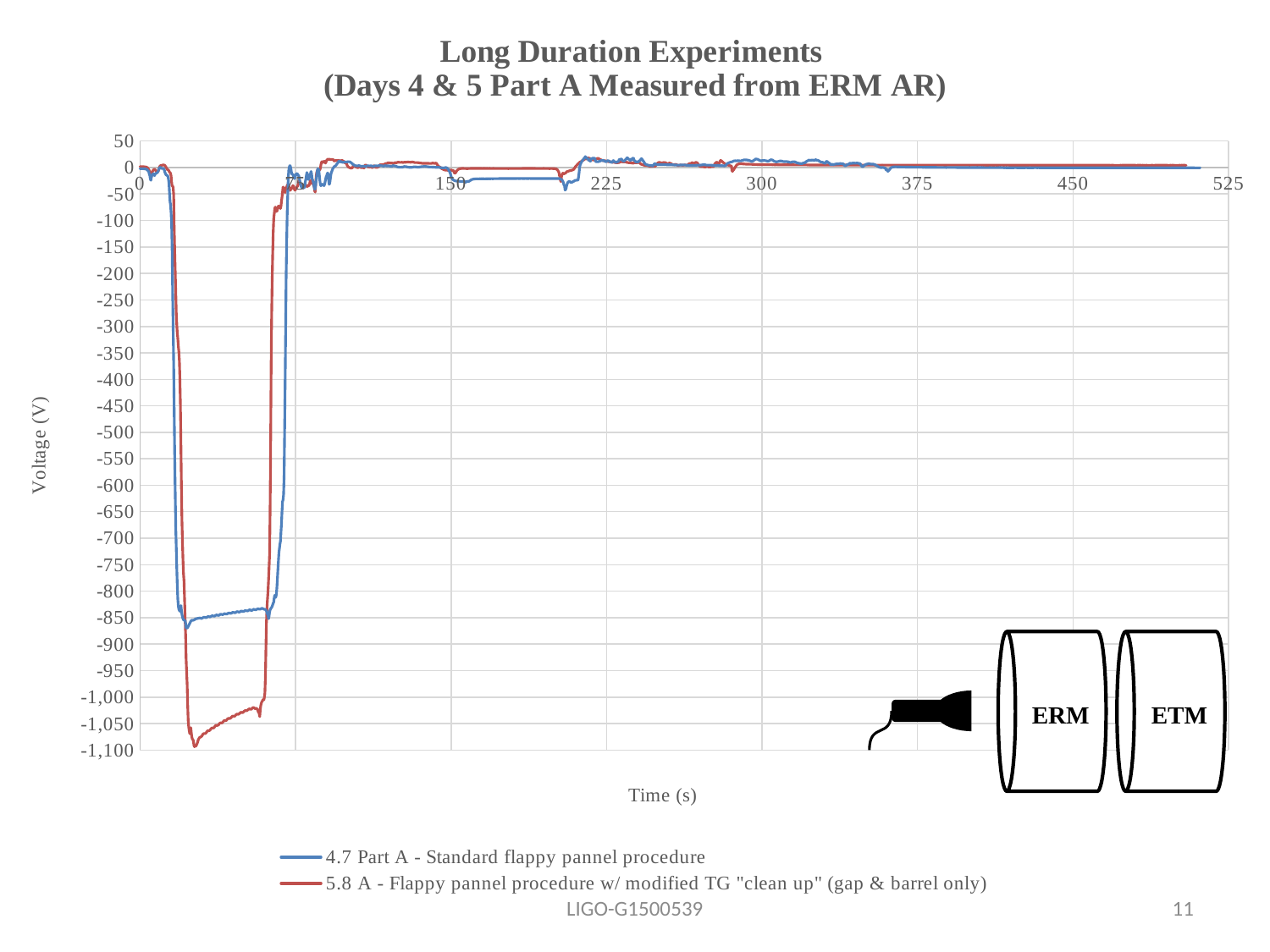
Which series reaches the lowest voltage, the blue '4.7 Part A' series or the red '5.8 A' series? 5.8 A - Flappy pannel procedure w/ modified TG "clean up" (gap & barrel only) How many series does the legend list? 2 Is the minimum voltage of the red '5.8 A' series greater or less than -1,000? less What is the label of the vertical axis? Voltage (V) Which series is drawn in blue? 4.7 Part A - Standard flappy pannel procedure Is the voltage of the red '5.8 A' series at 300 s greater or less than -500? greater Is the minimum voltage of the blue '4.7 Part A' series greater or less than -950? greater What is the highest value shown on the x axis (Time)? 525 After the large dip near the start, do the voltages of both series stay near 0 or keep falling as time increases? stay near 0 What kind of chart is shown on the slide? line chart